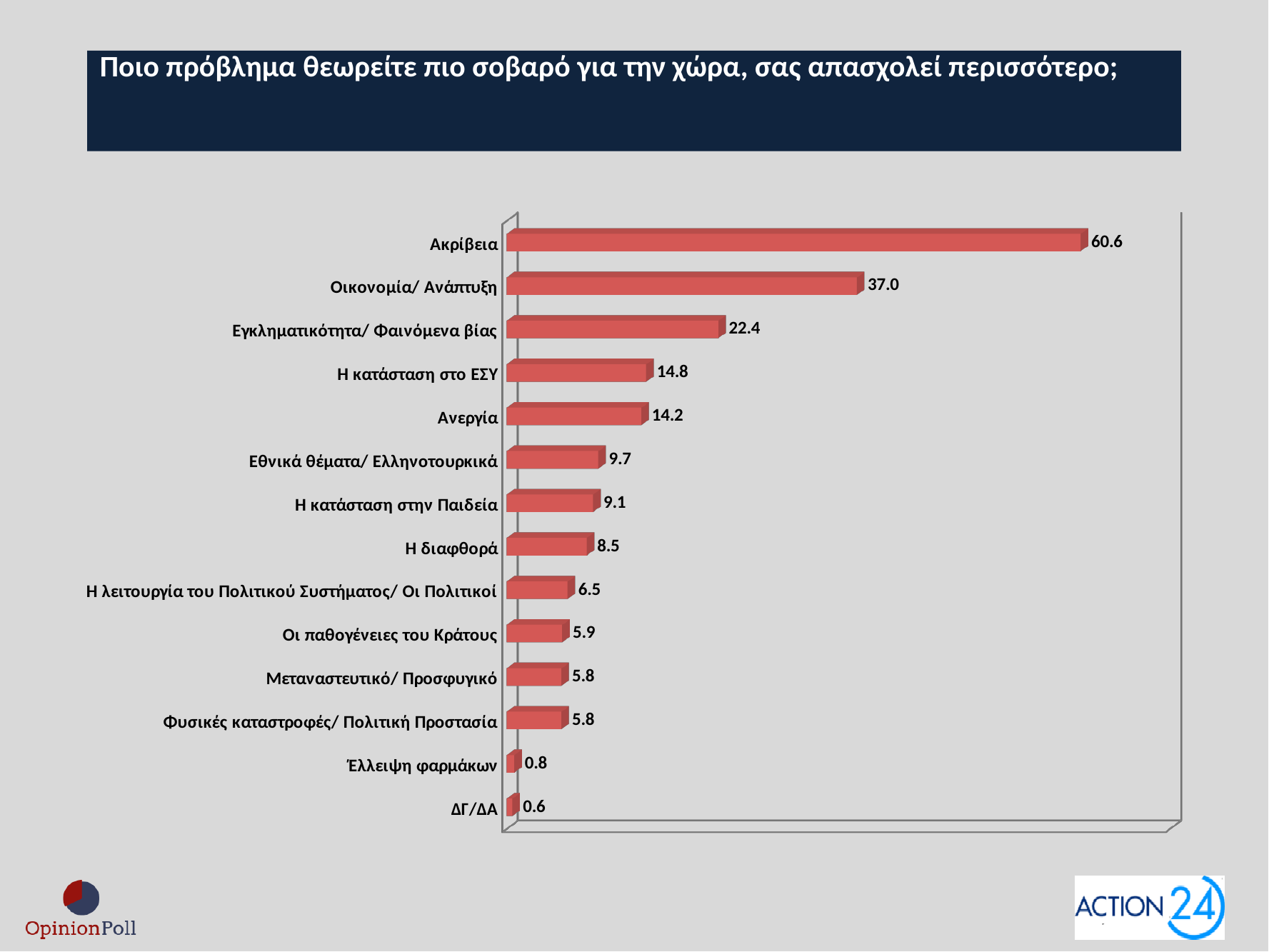
What is the difference between the values for Εγκληματικότητα/ Φαινόμενα βίας and Ανεργία? 8.2 What is the difference between the values for Ακρίβεια and Οικονομία/ Ανάπτυξη? 23.6 Which category has the highest value? Ακρίβεια What is the value for Έλλειψη φαρμάκων? 0.8 Which is larger, the value for Οικονομία/ Ανάπτυξη or the value for Εγκληματικότητα/ Φαινόμενα βίας? Οικονομία/ Ανάπτυξη What is the value for Μεταναστευτικό/ Προσφυγικό? 5.8 Which is larger, the value for Εθνικά θέματα/ Ελληνοτουρκικά or the value for Η διαφθορά? Εθνικά θέματα/ Ελληνοτουρκικά How many categories are shown in the chart? 14 What is the value for Ακρίβεια? 60.6 What is the value for Η κατάσταση στο ΕΣΥ? 14.8 What kind of chart is shown on the slide? Bar chart Which category has the lowest value? ΔΓ/ΔΑ